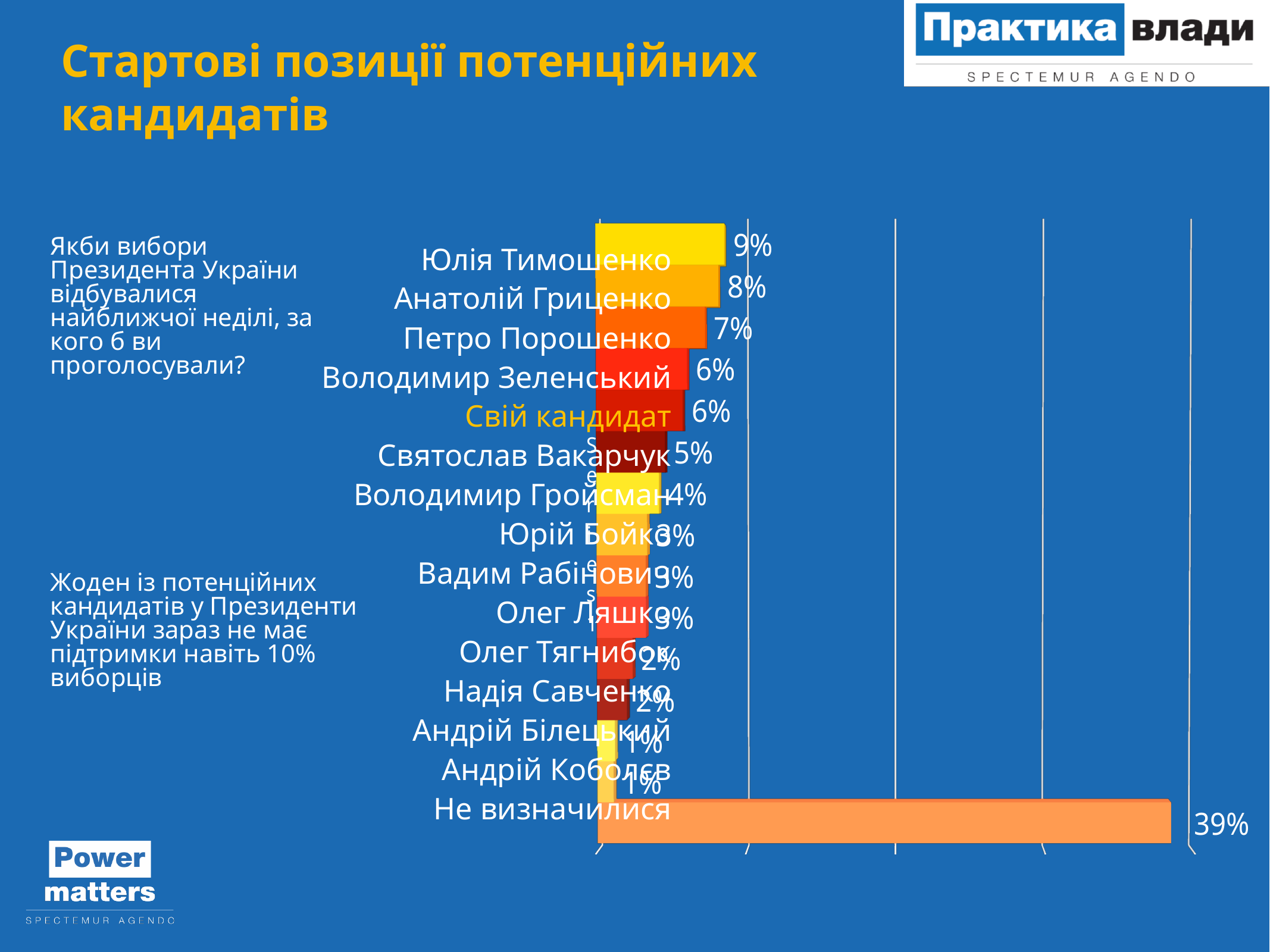
What is the value for Не визначилися? 39% What is the value for Юлія Тимошенко? 9% Which is larger, the value for Анатолій Гриценко or the value for Володимир Гройсман? Анатолій Гриценко Which category has the highest value? Не визначилися What is the difference between the values for Не визначилися and Юлія Тимошенко? 30% Which named candidate has the highest value? Юлія Тимошенко What is the value for Анатолій Гриценко? 8% What is the value for Петро Порошенко? 7% What is the difference between the values for Юлія Тимошенко and Петро Порошенко? 2% What kind of chart is shown on the slide? Bar chart What is the value for Святослав Вакарчук? 5% How many categories are shown in the chart? 15